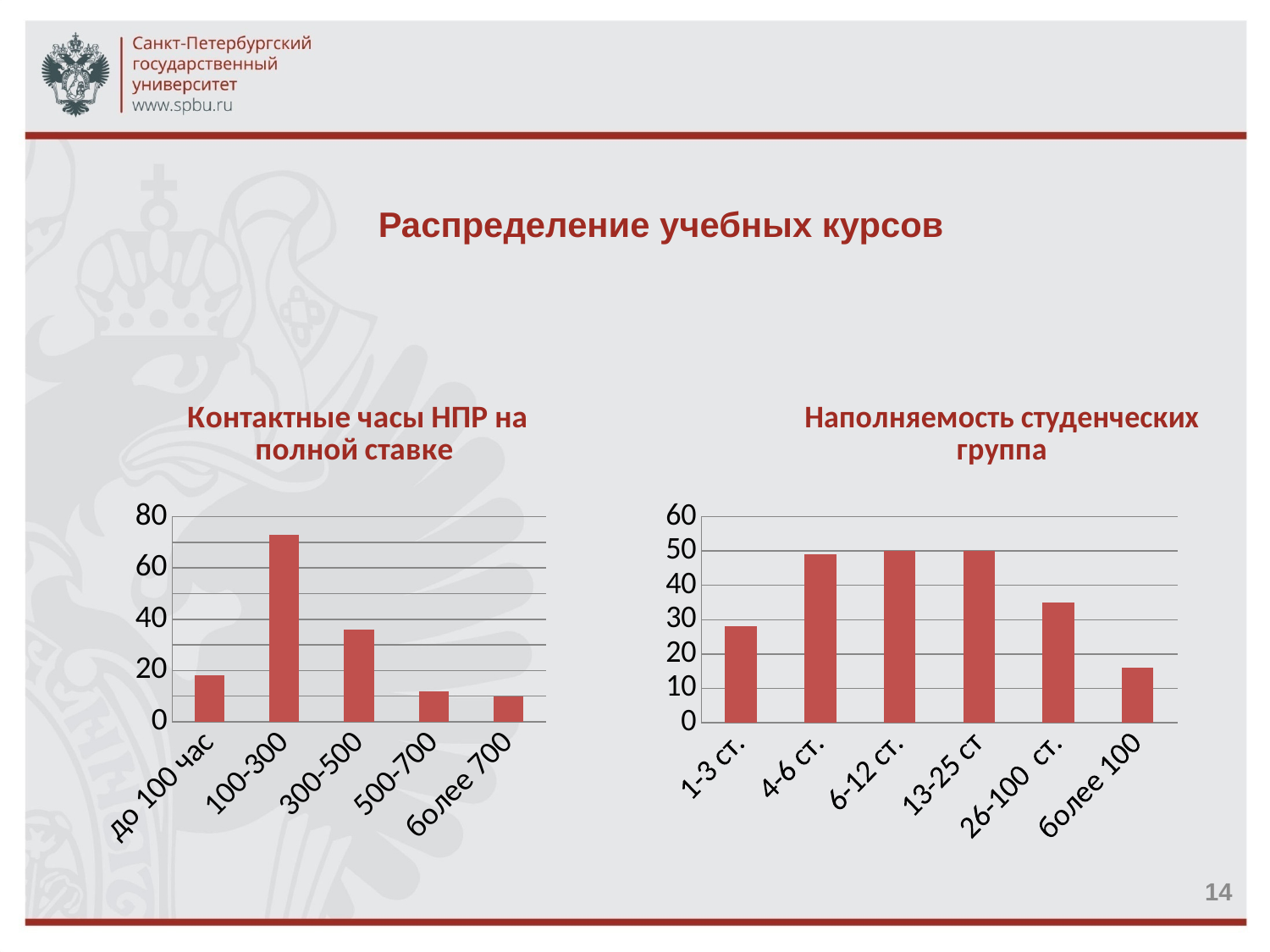
In the chart "Наполняемость студенческих группа", is the value for 26-100 ст. greater or less than 30? greater In the chart "Наполняемость студенческих группа", is the value for 1-3 ст. greater or less than 30? less In the chart "Контактные часы НПР на полной ставке", is the value for 100-300 greater or less than 60? greater In the chart "Наполняемость студенческих группа", how many categories are shown on the x axis? 6 In the chart "Контактные часы НПР на полной ставке", which is larger: the value for 300-500 or the value for до 100 час? 300-500 In the chart "Наполняемость студенческих группа", which is larger: the value for 4-6 ст. or the value for 1-3 ст.? 4-6 ст. In the chart "Наполняемость студенческих группа", which category has the lowest value? более 100 In the chart "Контактные часы НПР на полной ставке", how many categories are shown on the x axis? 5 What kind of chart is the chart titled "Контактные часы НПР на полной ставке"? bar chart What is the title of the chart on the right side of the slide? Наполняемость студенческих группа In the chart "Контактные часы НПР на полной ставке", which category has the highest value? 100-300